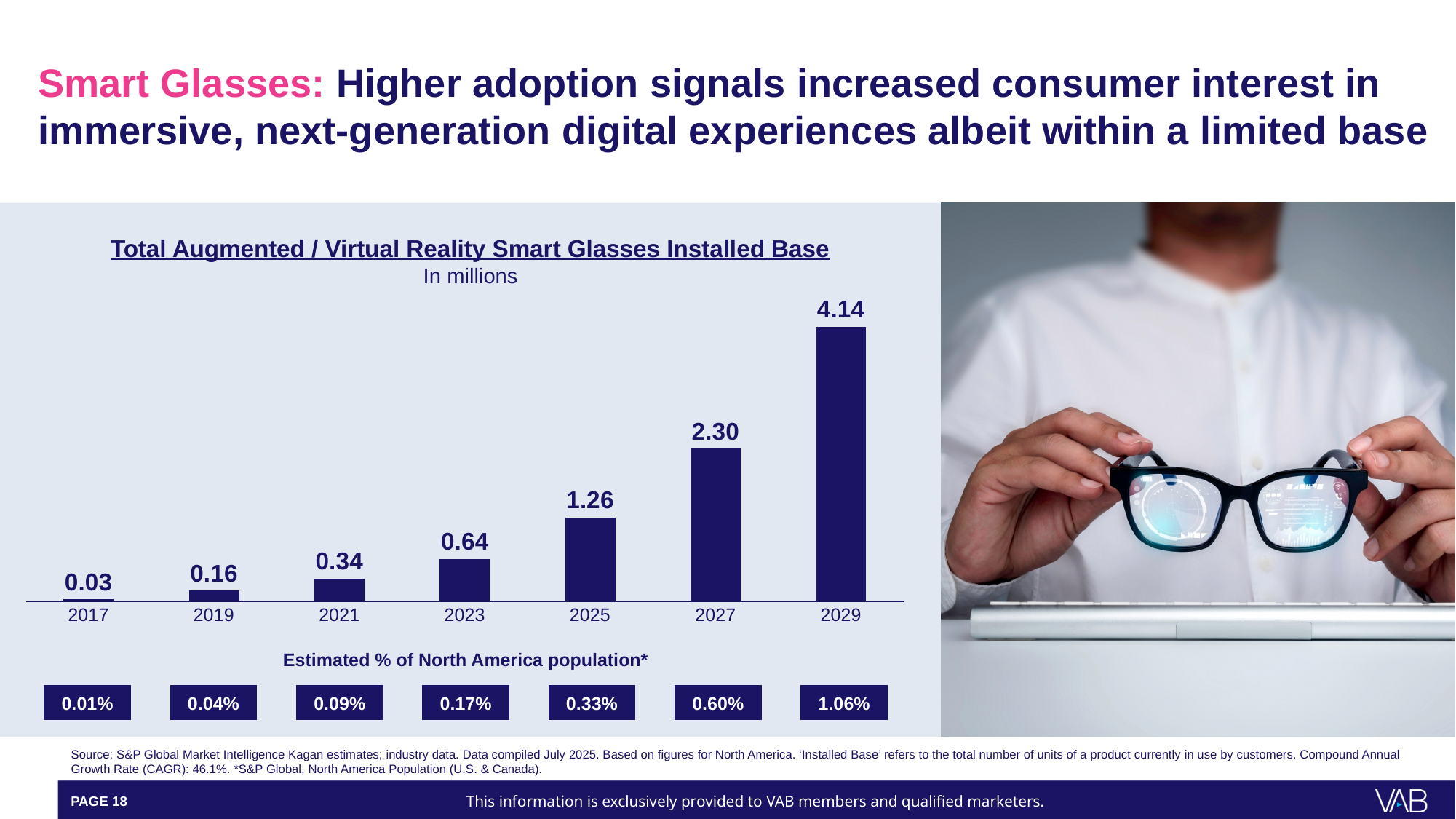
How many years are shown on the x axis of the chart? 7 Which year has the highest installed base value? 2029 What is the installed base value shown for 2029? 4.14 What kind of chart is used to show the installed base? Bar chart Do the installed base values rise or fall from 2017 to 2029? Rise What is the installed base value shown for 2023? 0.64 What is the installed base value shown for 2017? 0.03 What unit is the installed base chart measured in, according to its subtitle? In millions What is the difference between the installed base values for 2029 and 2027? 1.84 Which is larger, the installed base value for 2025 or for 2021? 2025 Which year has the lowest installed base value? 2017 What is the estimated % of North America population shown for 2027? 0.60%